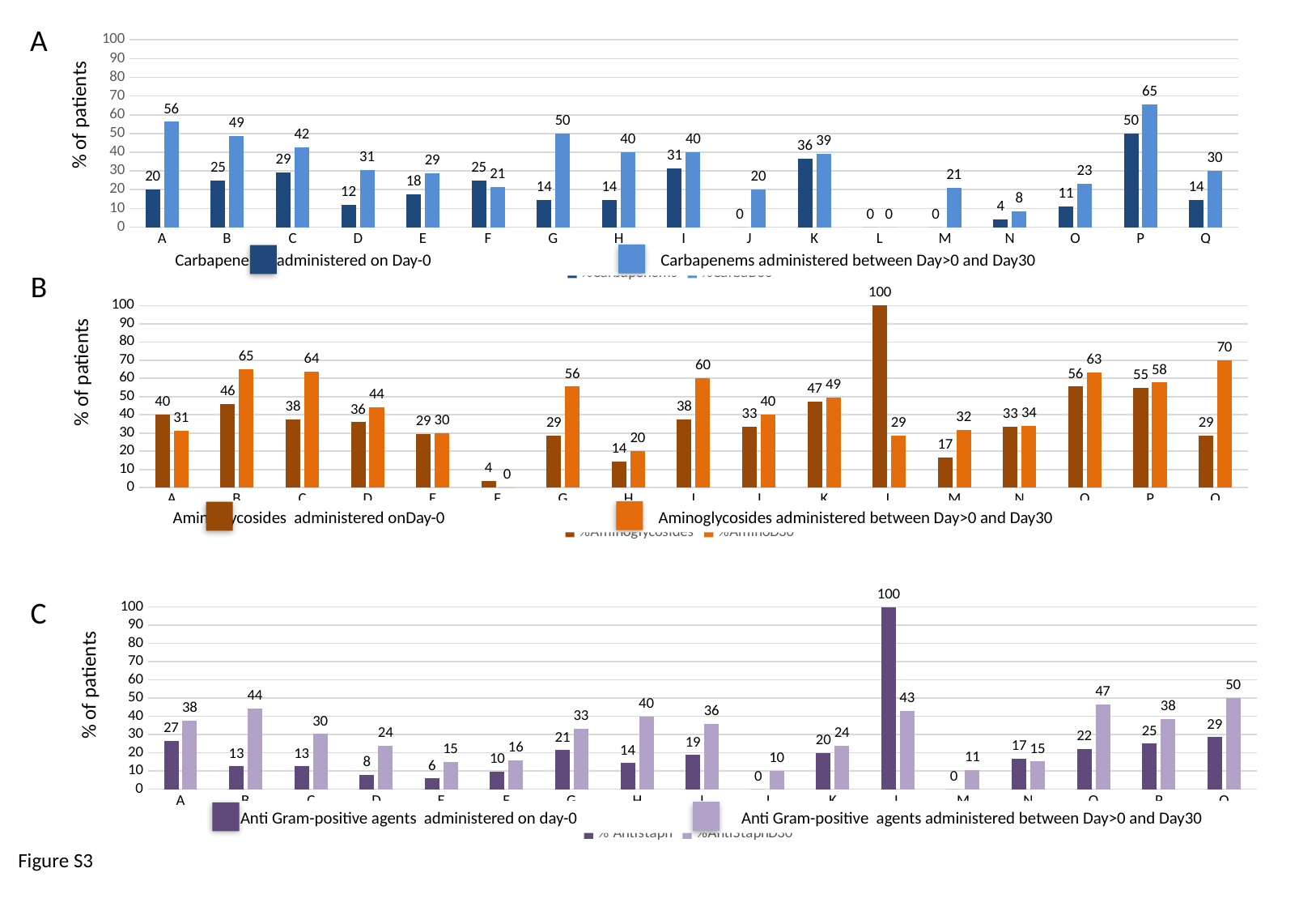
In chart B (middle chart), which category has the highest value for aminoglycosides administered on Day-0? L In chart C (bottom chart), which category has the lowest value for anti Gram-positive agents administered between Day>0 and Day30? J In chart B (middle chart), what is the value for aminoglycosides administered between Day>0 and Day30 for category Q? 70 In chart A (top chart), what percentage of patients in category P received carbapenems administered on Day-0? 50 In chart B (middle chart), which is larger for category A: aminoglycosides administered on Day-0 or between Day>0 and Day30? Administered on Day-0 How many categories are shown on the x axis of chart A (top chart)? 17 In chart A (top chart), which category has the highest value for carbapenems administered between Day>0 and Day30? P In chart C (bottom chart), what is the difference between the two bars for category H? 26 In chart A (top chart), what is the difference between the two bars for category A? 36 In chart C (bottom chart), what is the value for anti Gram-positive agents administered on day-0 for category L? 100 What type of chart is chart B (middle chart)? Bar chart What is the y-axis label of chart C (bottom chart)? % of patients